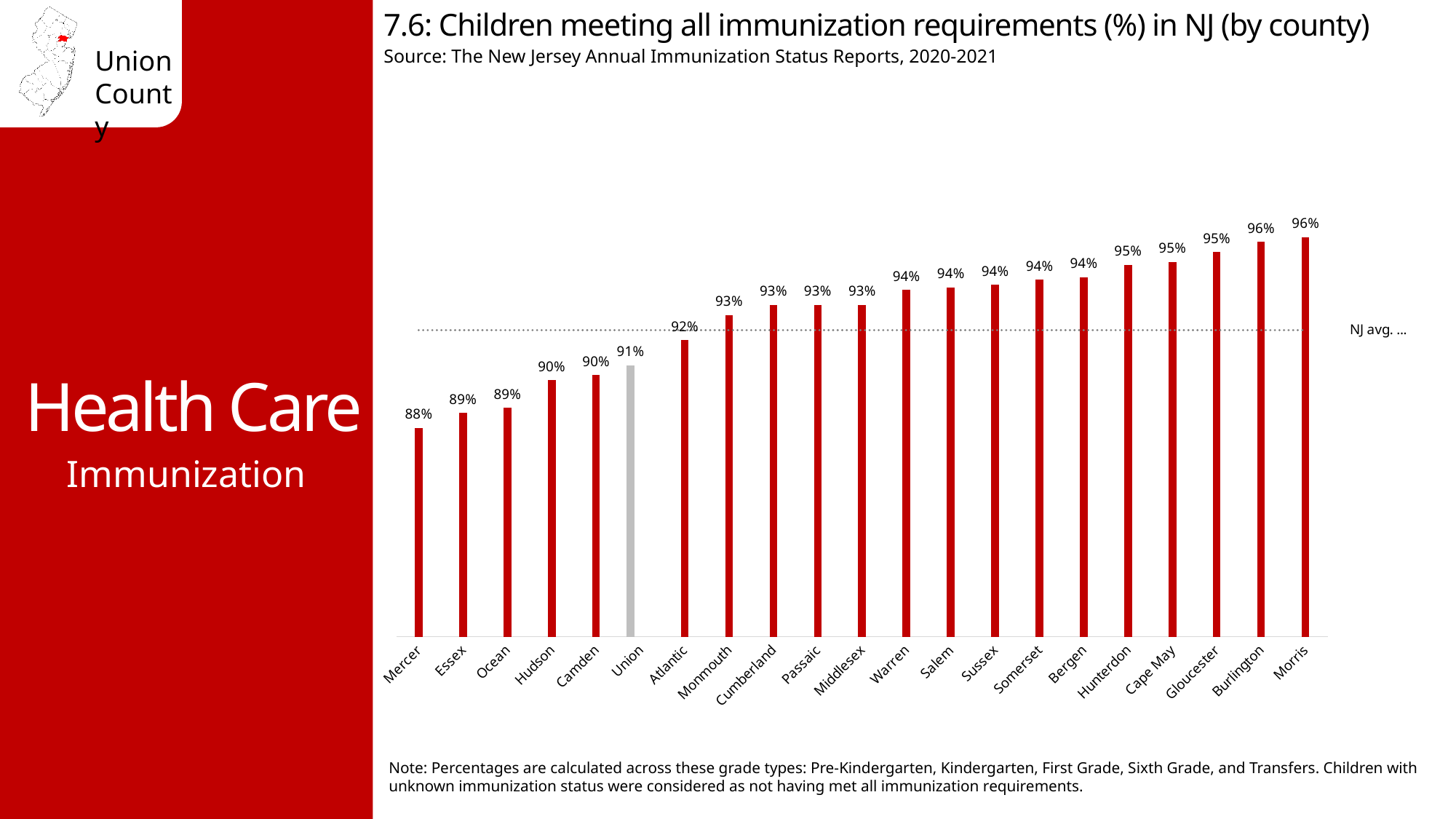
Do the values rise or fall moving from left to right along the x axis? Rise What kind of chart is used on this slide? Bar chart Which county has the lowest percentage of children meeting all immunization requirements? Mercer What is the value shown for Morris County? 96% How many counties are shown on the chart? 21 What is the value shown for Atlantic County? 92% What is the difference in percentage points between Union County and Mercer County? 3 percentage points What percentage of children in Union County met all immunization requirements? 91% Which county's bar is coloured grey instead of red? Union What is the difference in percentage points between Morris County and Mercer County? 8 percentage points What is the value shown for Mercer County? 88% Which has a higher value, Union County or Atlantic County? Atlantic